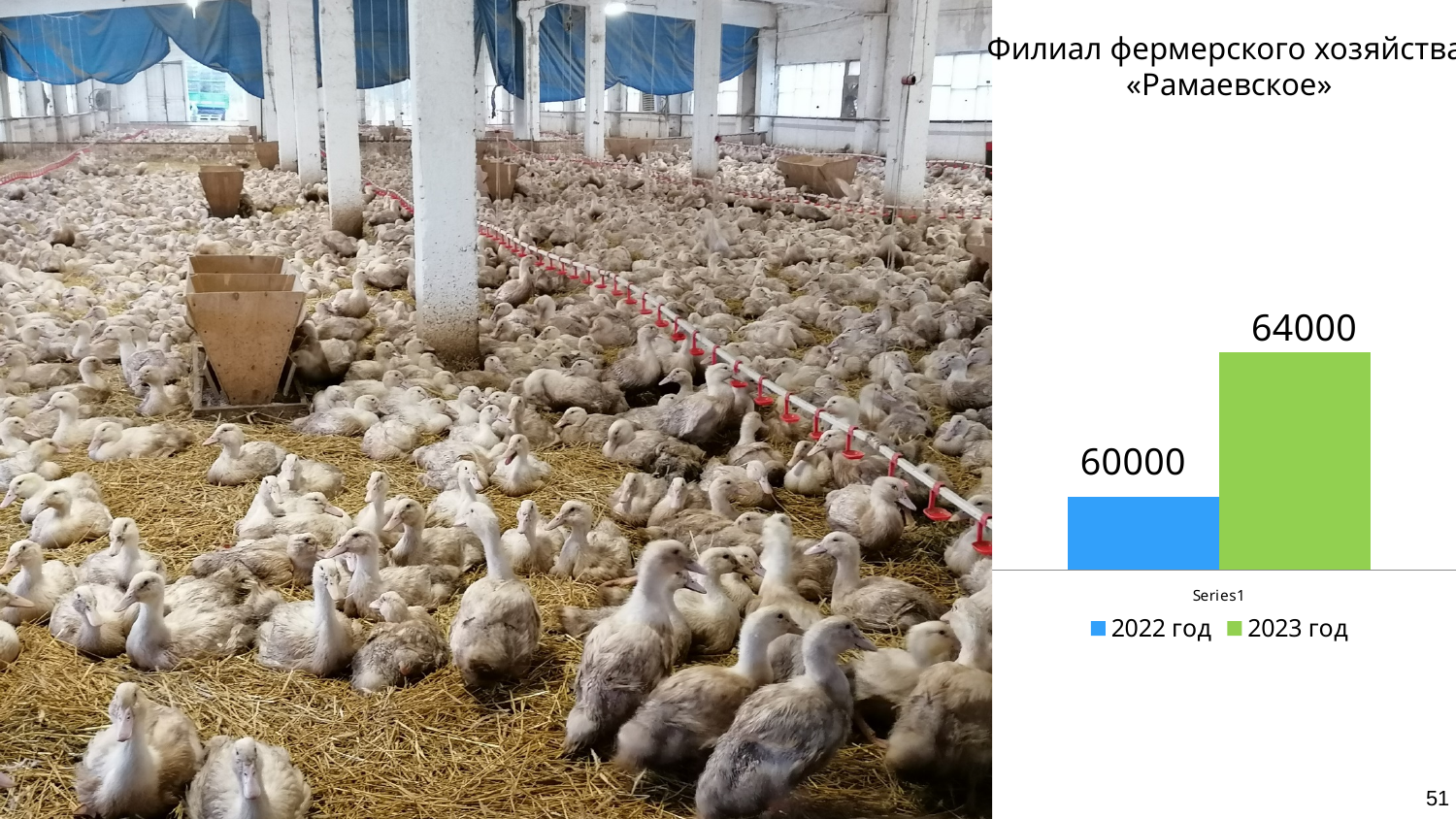
What is the value for 2023 год? 64000 What colour is the bar for 2023 год? green What is the value for 2022 год? 60000 How many series does the legend list? 2 Is the value for 2022 год larger or smaller than the value for 2023 год? smaller Which series has the higher value, 2022 год or 2023 год? 2023 год What is the category label shown on the x axis? Series1 Do the values rise or fall from 2022 год to 2023 год? rise What is the difference between the 2023 год and 2022 год values? 4000 What kind of chart is shown on the slide? bar chart Which series has the lower value? 2022 год